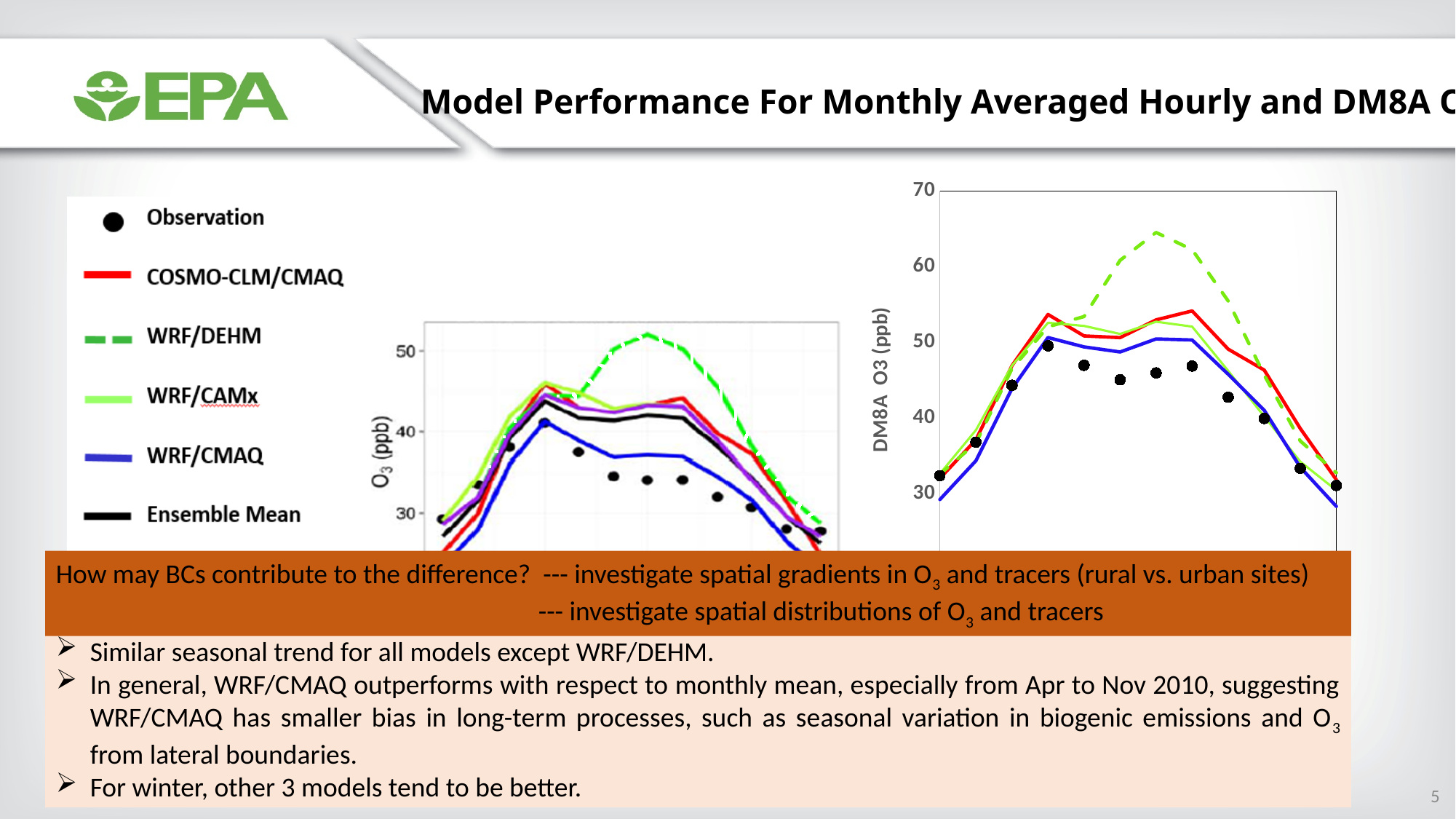
In the right chart (DM8A O3), which series reaches the highest peak value? WRF/DEHM In the right chart (DM8A O3), is the peak value of WRF/DEHM greater or less than 60? greater In the right chart (DM8A O3), is the first Observation point greater or less than 30? greater What kind of chart is the right chart with the DM8A O3 (ppb) axis? line chart In the left chart (O3 ppb), is the peak value of WRF/DEHM greater or less than 50? greater In the legend, which series is shown as black dots? Observation In the legend, which series is drawn as a dashed green line? WRF/DEHM In the left chart (O3 ppb), which series reaches the highest peak value? WRF/DEHM How many series does the legend list? 6 What kind of chart is the left chart with the O3 (ppb) axis? line chart How many Observation points are plotted in the right chart (DM8A O3)? 12